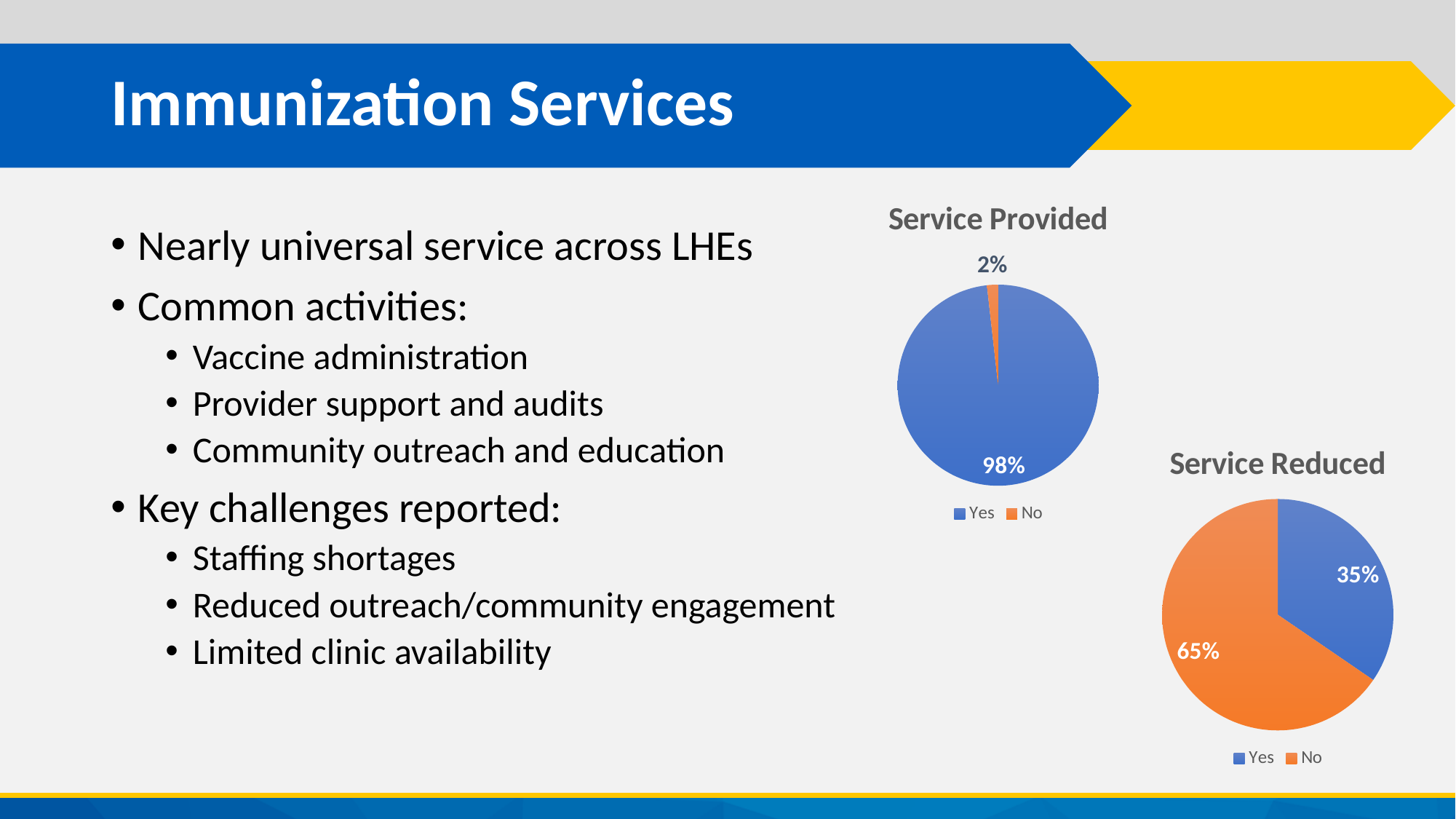
In the 'Service Provided' chart, which slice is the largest? Yes In the 'Service Provided' chart, what is the difference between the Yes and No percentages? 96% In the 'Service Reduced' chart, which slice is larger, Yes or No? No In the 'Service Reduced' chart, what is the difference between the No and Yes percentages? 30% In the 'Service Provided' chart, what percentage is shown for Yes? 98% In the 'Service Reduced' chart, what percentage is shown for Yes? 35% What type of chart is the 'Service Reduced' chart? Pie chart In the 'Service Reduced' chart, what percentage is shown for No? 65% How many entries does the legend of the 'Service Provided' chart list? 2 In the 'Service Reduced' chart, what colour is the No slice? Orange In the 'Service Provided' chart, what percentage is shown for No? 2% In the 'Service Reduced' chart, which slice is the smallest? Yes